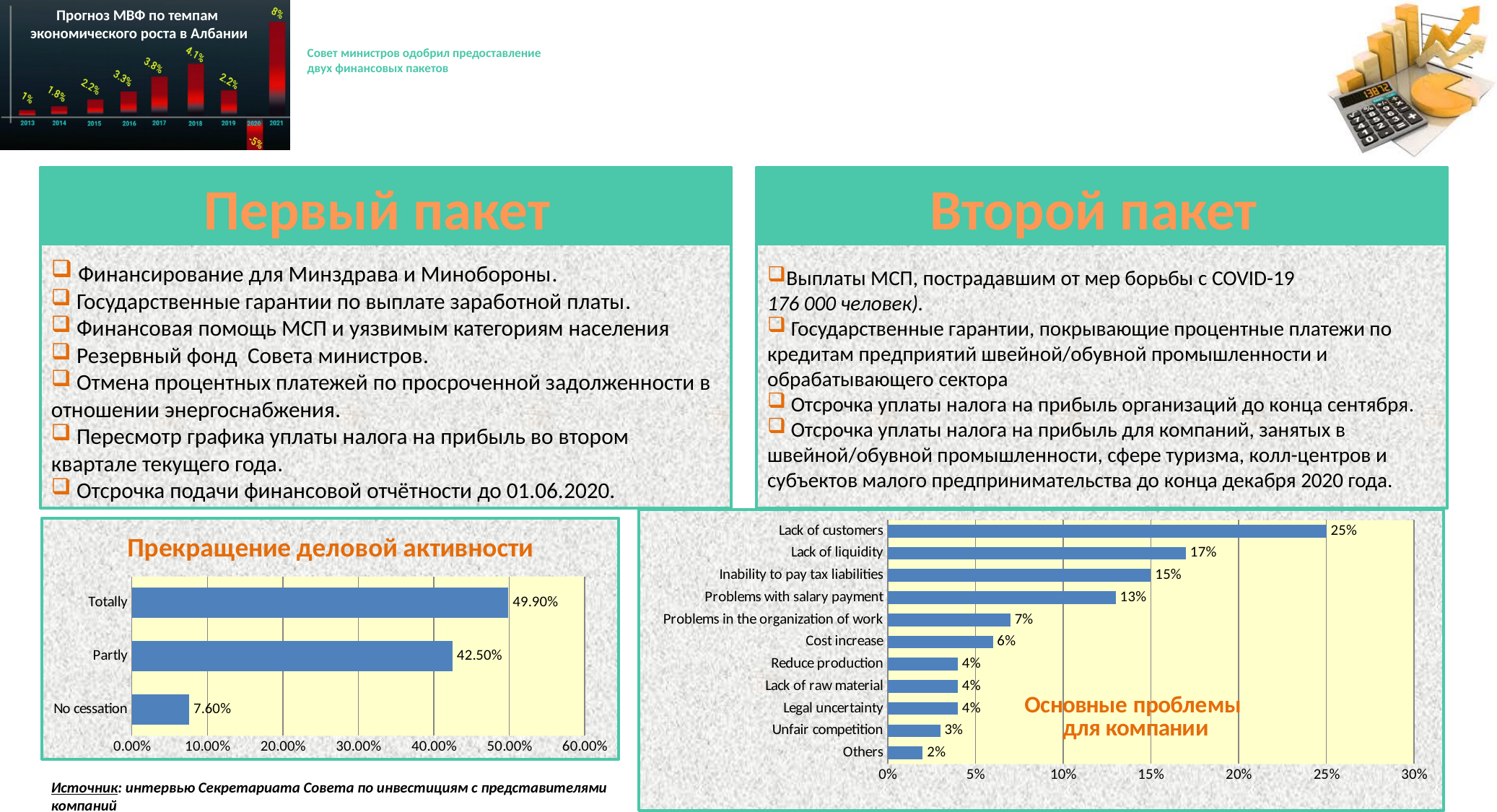
In the chart 'Прекращение деловой активности', which category has the lowest value? No cessation In the chart 'Основные проблемы для компании', what is the value for Lack of liquidity? 17% In the chart 'Прогноз МВФ по темпам экономического роста в Албании' at the top left, what is the value for 2020? -5% In the chart 'Прекращение деловой активности', what is the value for No cessation? 7.60% In the chart 'Основные проблемы для компании', which category has the highest value? Lack of customers In the chart 'Прогноз МВФ по темпам экономического роста в Албании' at the top left, which year has the highest value? 2021 In the chart 'Прекращение деловой активности', what is the difference between Totally and Partly? 7.40% What kind of chart is 'Прекращение деловой активности'? Bar chart In the chart 'Прекращение деловой активности', what is the value for Totally? 49.90% In the chart 'Основные проблемы для компании', which is larger: Problems with salary payment or Cost increase? Problems with salary payment In the chart 'Основные проблемы для компании', how many categories are shown? 11 In the chart 'Основные проблемы для компании', what is the difference between Lack of customers and Inability to pay tax liabilities? 10%